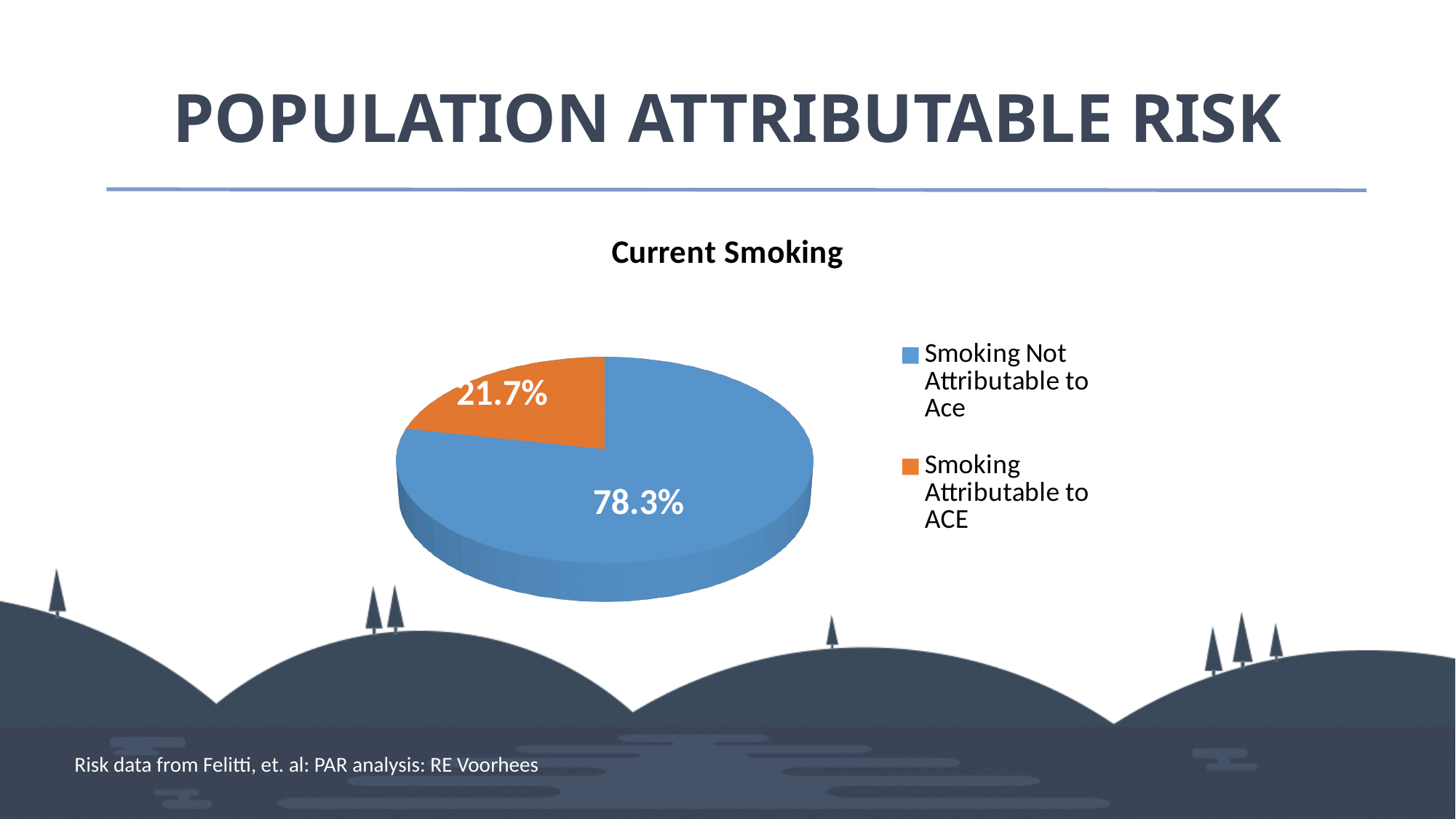
Which slice of the pie is the largest? Smoking Not Attributable to Ace What is the title of the chart? Current Smoking How many slices does the pie chart have? 2 Which is larger: the Smoking Attributable to ACE slice or the Smoking Not Attributable to Ace slice? Smoking Not Attributable to Ace What colour is the Smoking Attributable to ACE slice? Orange What share of the pie does the Smoking Attributable to ACE slice represent? 21.7% What kind of chart is shown on the slide? Pie chart What percentage of the pie is labelled for Smoking Attributable to ACE? 21.7% What is the difference in percentage points between the Smoking Not Attributable to Ace slice and the Smoking Attributable to ACE slice? 56.6 What percentage of the pie is labelled for Smoking Not Attributable to Ace? 78.3% Which slice of the pie is the smallest? Smoking Attributable to ACE How many entries does the legend list? 2